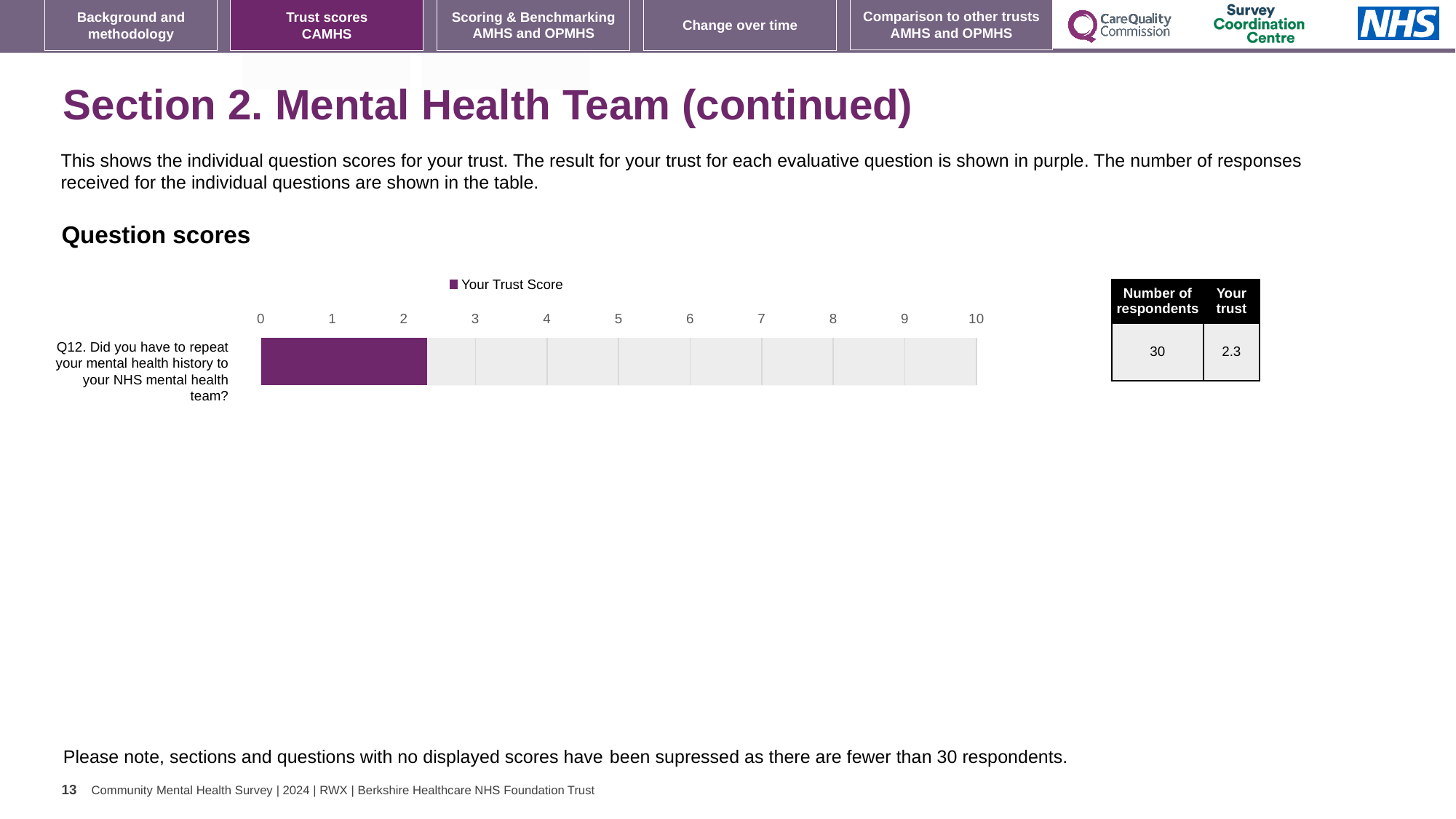
How many questions (categories) are plotted in the chart? 1 Is the bar for Q12 greater or less than 2 on the axis? greater What kind of chart is shown under 'Question scores'? bar chart What is the name of the series shown in the chart legend? Your Trust Score What colour is the bar representing the trust score? purple How many respondents answered Q12 according to the table beside the chart? 30 Is the bar for Q12 greater or less than 3 on the axis? less How many series does the chart legend list? 1 What is the trust score for Q12 (Did you have to repeat your mental health history to your NHS mental health team?)? 2.3 What is the maximum value shown on the chart's axis? 10 Is the bar for Q12 greater or less than 5 on the axis? less